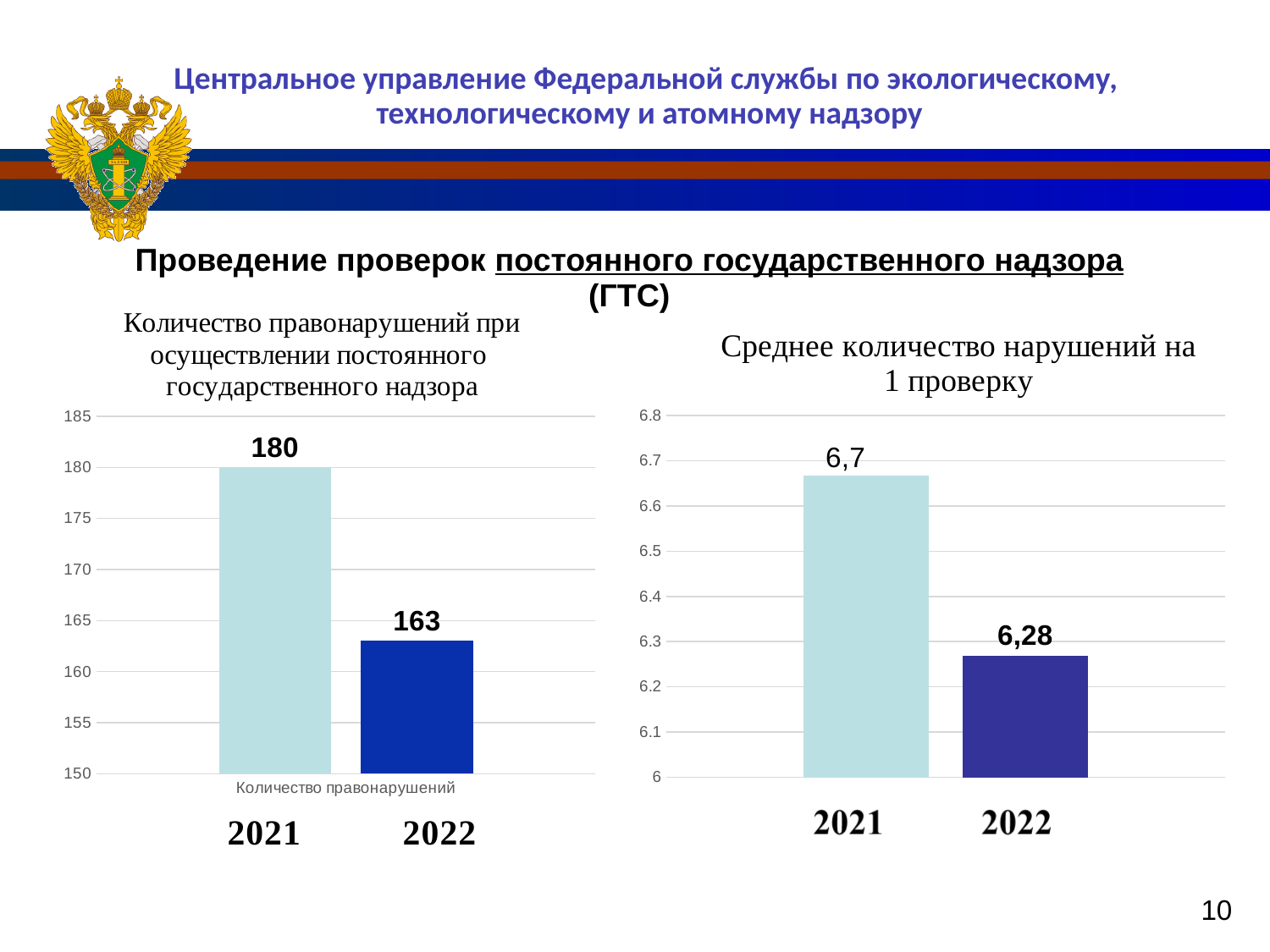
In the right chart (Среднее количество нарушений на 1 проверку), what is the value for 2021? 6,7 In the right chart (Среднее количество нарушений на 1 проверку), which year has the lowest value? 2022 In the left chart (Количество правонарушений), which year has the higher value, 2021 or 2022? 2021 In the right chart (Среднее количество нарушений на 1 проверку), what is the value for 2022? 6,28 In the right chart (Среднее количество нарушений на 1 проверку), is the value for 2022 greater or less than 6.5? less In the left chart (Количество правонарушений), do the values rise or fall from 2021 to 2022? fall How many bars are plotted in the right chart (Среднее количество нарушений на 1 проверку)? 2 What is the title of the right chart on the slide? Среднее количество нарушений на 1 проверку In the left chart (Количество правонарушений при осуществлении постоянного государственного надзора), what is the value for 2022? 163 In the left chart (Количество правонарушений при осуществлении постоянного государственного надзора), what is the value for 2021? 180 In the left chart (Количество правонарушений), what is the difference between the 2021 and 2022 values? 17 What kind of chart is the left chart (Количество правонарушений при осуществлении постоянного государственного надзора)? bar chart